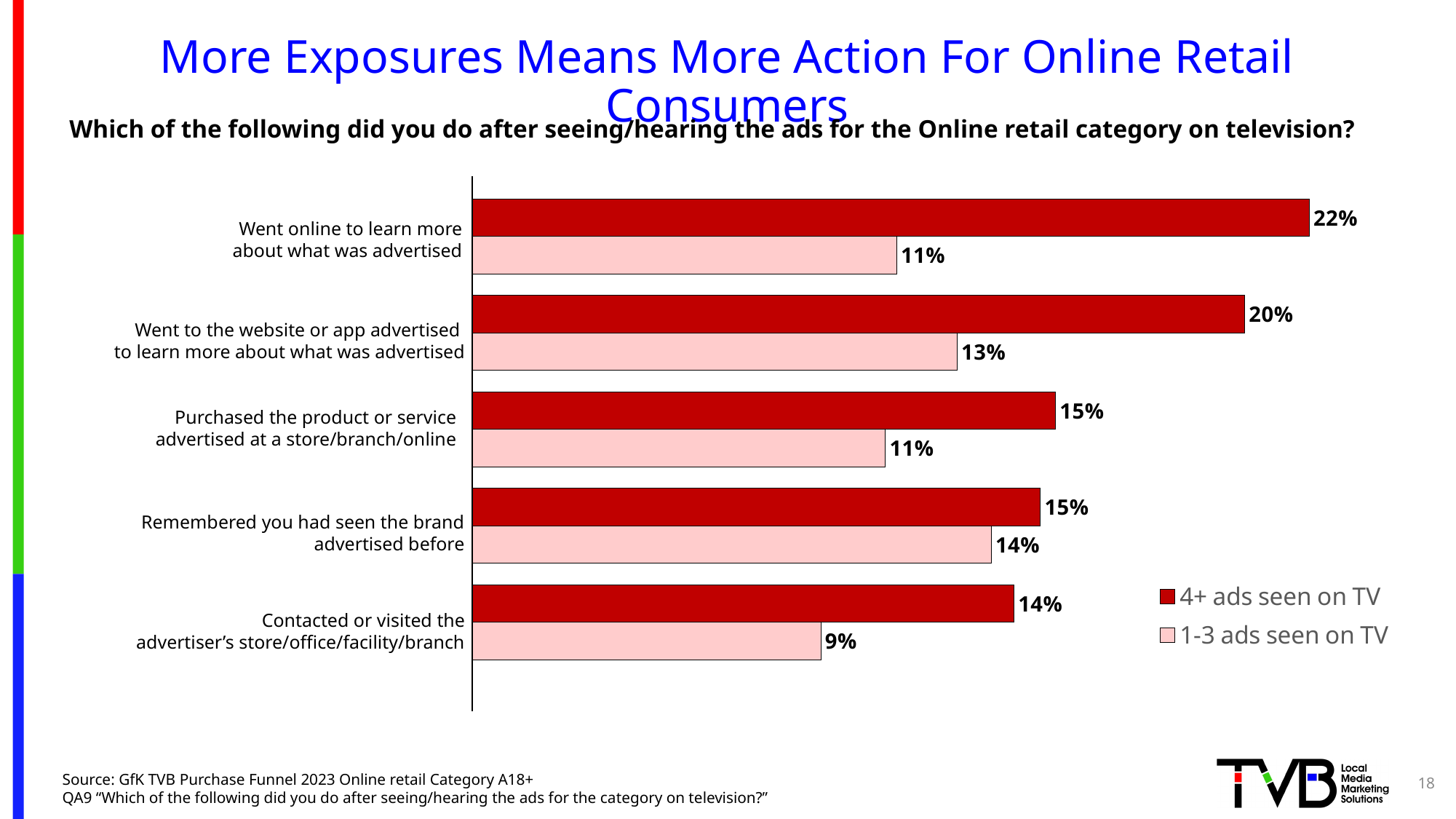
For 'Purchased the product or service advertised at a store/branch/online', which group has the larger value: 4+ ads seen on TV or 1-3 ads seen on TV? 4+ ads seen on TV Which colour represents the '1-3 ads seen on TV' series? Light pink How many actions (categories) are shown in the chart? 5 What is the difference between the 4+ ads and 1-3 ads values for 'Remembered you had seen the brand advertised before'? 1 percentage point Which action has the highest value for the '4+ ads seen on TV' series? Went online to learn more about what was advertised What percentage of those who saw 4+ ads on TV went online to learn more about what was advertised? 22% How many series does the legend list? 2 What type of chart is shown on the slide? Bar chart What percentage of those who saw 1-3 ads on TV went to the website or app advertised to learn more about what was advertised? 13% Which action has the lowest value for the '1-3 ads seen on TV' series? Contacted or visited the advertiser's store/office/facility/branch What is the value for 'Contacted or visited the advertiser's store/office/facility/branch' among those who saw 1-3 ads on TV? 9% What is the difference between the 4+ ads and 1-3 ads values for 'Went online to learn more about what was advertised'? 11 percentage points